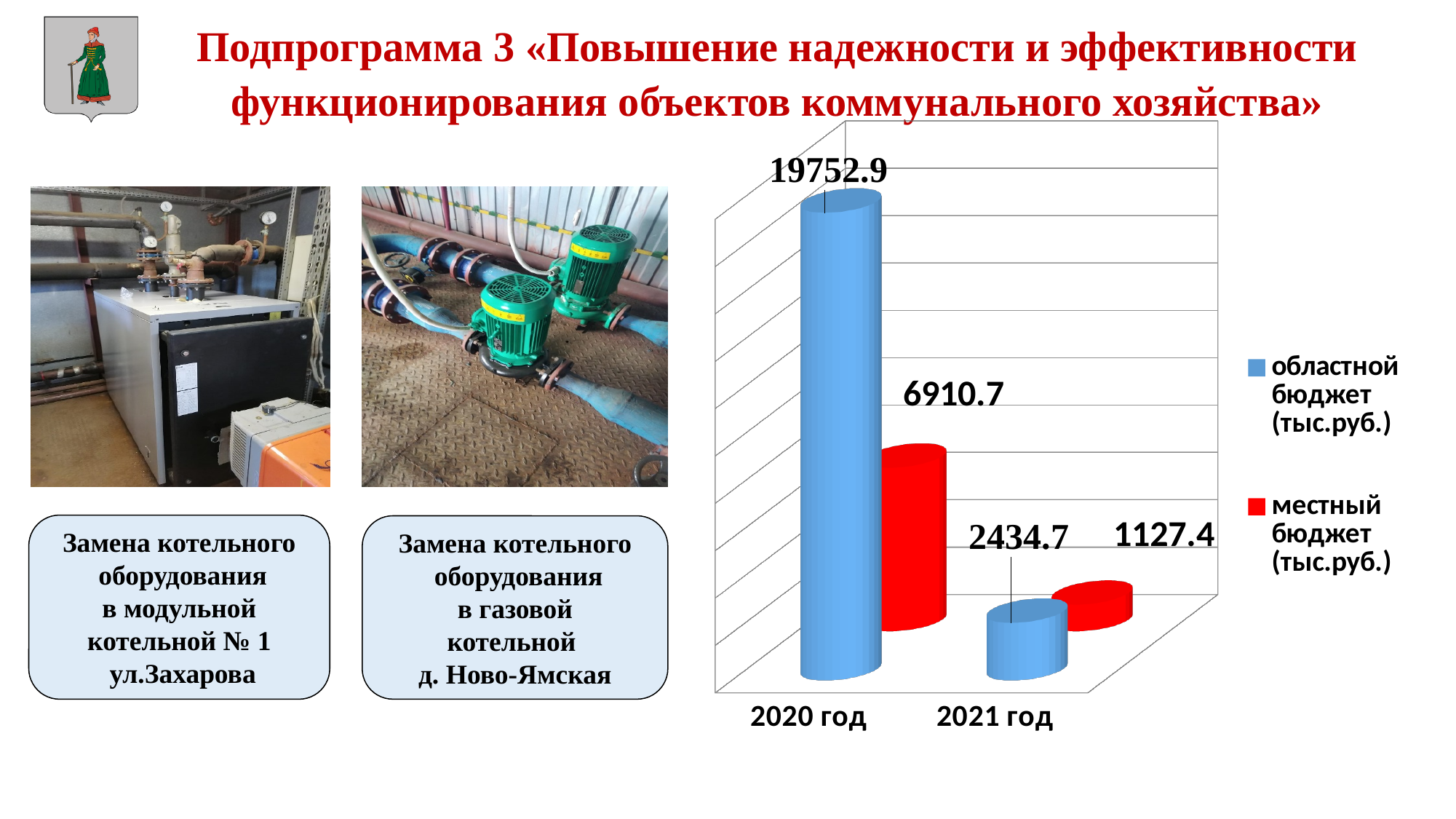
What is the value for областной бюджет in 2020 год? 19752.9 How many series does the legend list? 2 What is the difference between областной бюджет in 2020 год and областной бюджет in 2021 год? 17318.2 How many years are shown on the x axis of the chart? 2 What is the difference between областной бюджет and местный бюджет in 2020 год? 12842.2 Which year has the highest value for областной бюджет? 2020 год What kind of chart is shown on the slide? bar chart What is the value for местный бюджет in 2021 год? 1127.4 Which year has the lowest value for местный бюджет? 2021 год What is the value for областной бюджет in 2021 год? 2434.7 What is the value for местный бюджет in 2020 год? 6910.7 Which is larger in 2021 год: областной бюджет or местный бюджет? областной бюджет